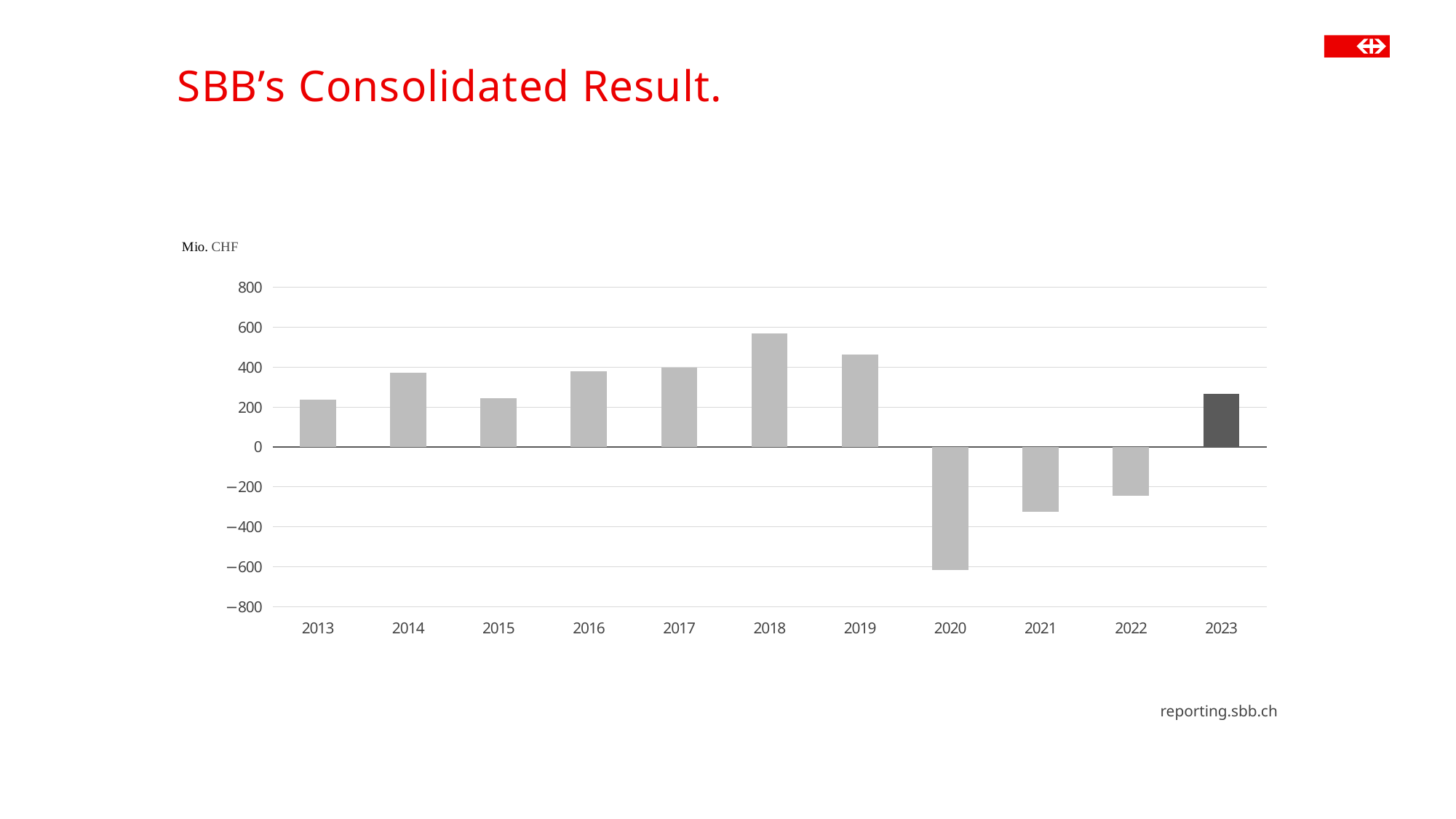
How many years are shown on the x axis of the chart? 11 Is the value for 2018 greater or less than 400? greater Which year has the larger value, 2013 or 2014? 2014 Which year has the larger value, 2018 or 2019? 2018 What kind of chart is shown on the slide? bar chart Is the value for 2021 greater or less than -200? less Which year has the lowest consolidated result? 2020 Do the values rise or fall from 2020 to 2023? rise Which year has the highest consolidated result? 2018 Is the value for 2013 greater or less than 200? greater What unit is shown above the y axis of the chart? Mio. CHF